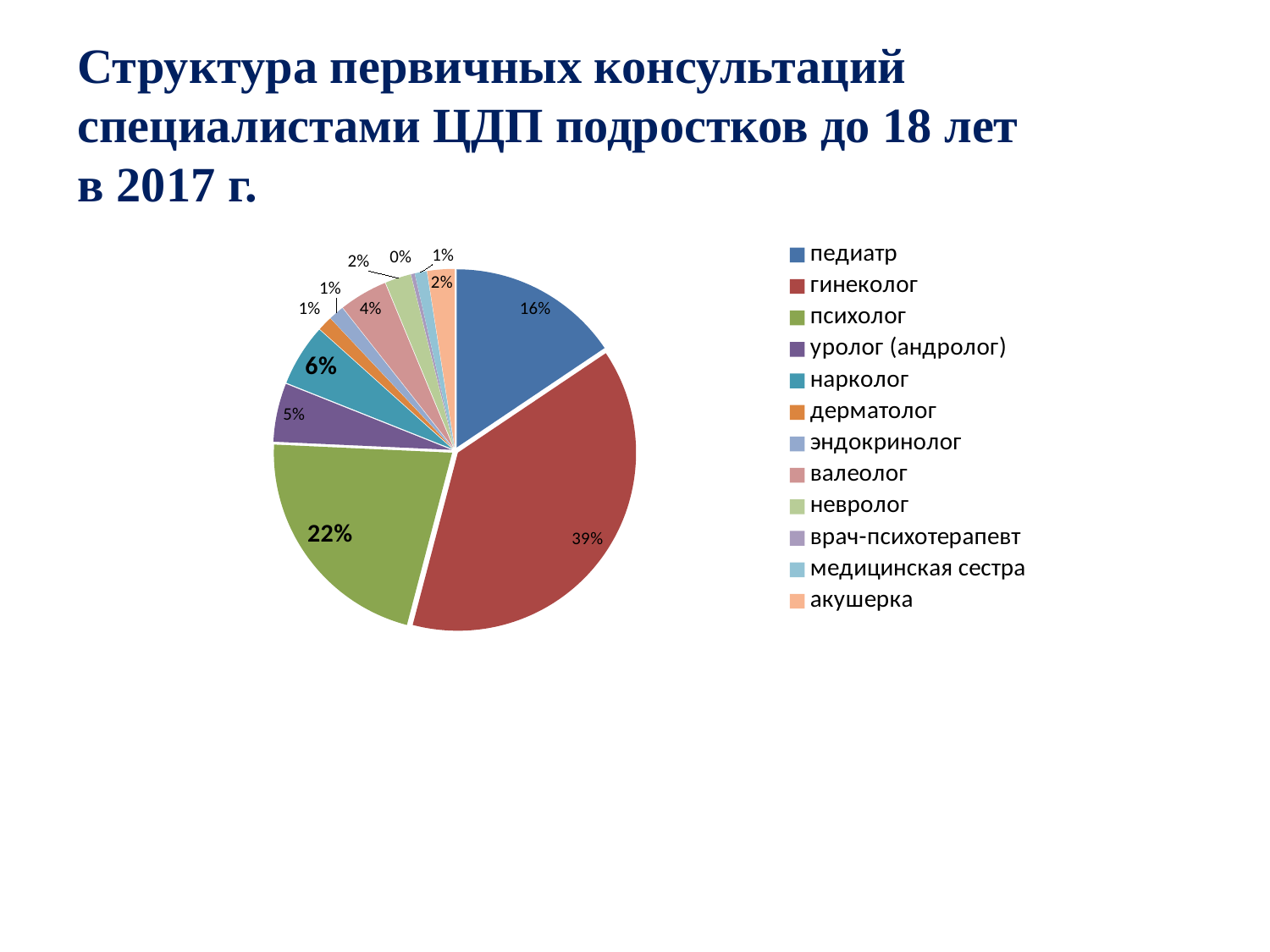
What is the title of the slide? Структура первичных консультаций специалистами ЦДП подростков до 18 лет в 2017 г. Which category has the largest slice of the pie? гинеколог What kind of chart is shown on the slide? pie chart What share of the pie does гинеколог have? 39% What share of the pie does валеолог have? 4% What share of the pie does психолог have? 22% Which category has the smallest slice of the pie? врач-психотерапевт Which has a larger share, педиатр or уролог (андролог)? педиатр What is the difference between the shares of гинеколог and психолог? 17% How many categories does the legend list? 12 What share of the pie does педиатр have? 16% What share of the pie does нарколог have? 6%